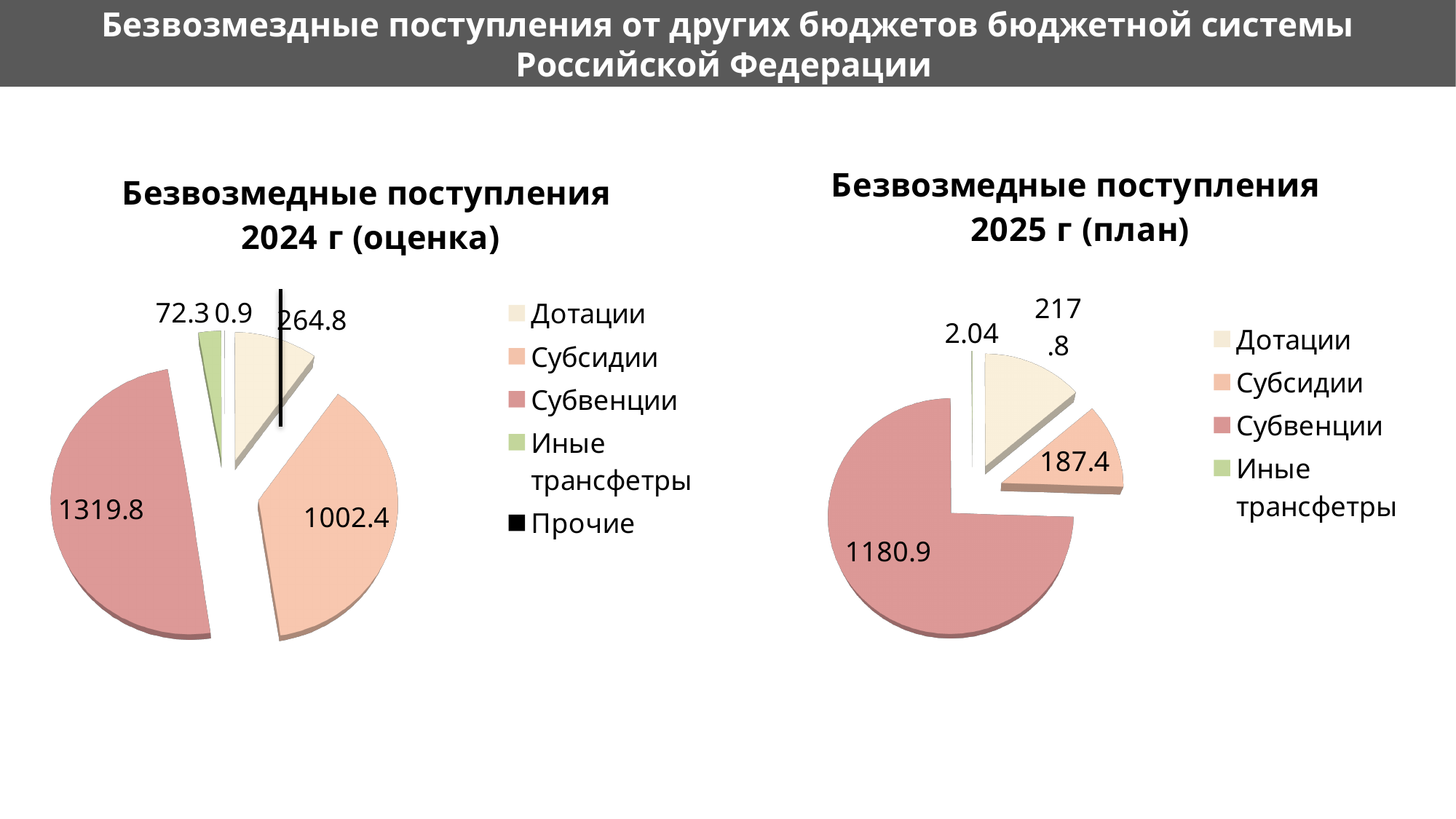
What kind of chart is the chart titled "Безвозмедные поступления 2025 г (план)"? Pie chart In the chart titled "Безвозмедные поступления 2024 г (оценка)", what is the value for Субсидии? 1002.4 In the chart titled "Безвозмедные поступления 2025 г (план)", what is the value for Субвенции? 1180.9 In the chart titled "Безвозмедные поступления 2024 г (оценка)", which category has the largest value? Субвенции How many categories does the legend of the chart titled "Безвозмедные поступления 2024 г (оценка)" list? 5 In the chart titled "Безвозмедные поступления 2025 г (план)", which category has the smallest value? Иные трансферты In the chart titled "Безвозмедные поступления 2024 г (оценка)", which category has the smallest value? Прочие In the chart titled "Безвозмедные поступления 2024 г (оценка)", what is the value for Субвенции? 1319.8 In the chart titled "Безвозмедные поступления 2024 г (оценка)", what is the difference between Субвенции and Субсидии? 317.4 In the chart titled "Безвозмедные поступления 2025 г (план)", what is the value for Иные трансферты? 2.04 In the chart titled "Безвозмедные поступления 2025 г (план)", which is larger, Дотации or Субсидии? Дотации How many slices does the chart titled "Безвозмедные поступления 2025 г (план)" have? 4